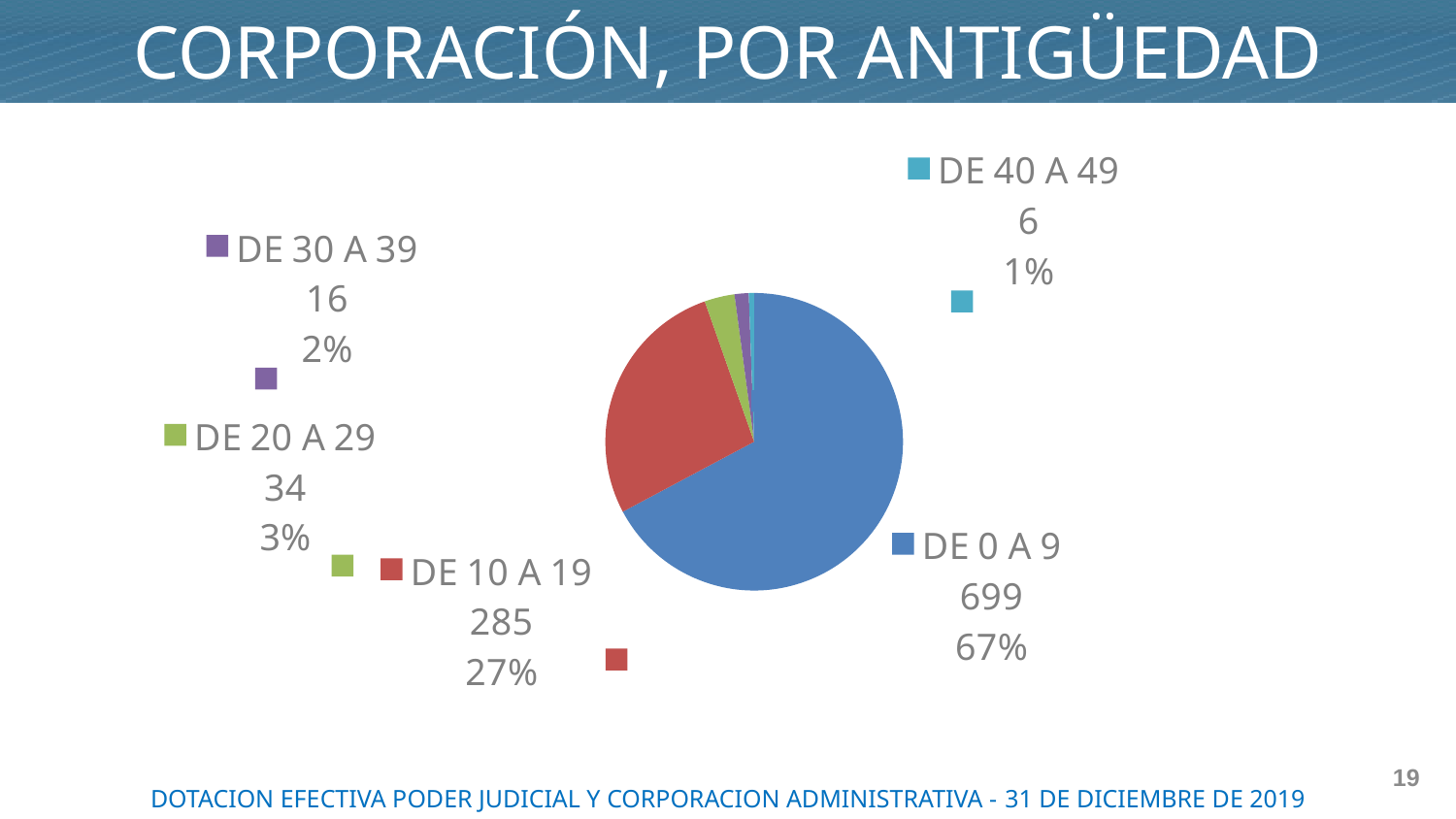
What is the value for DE 20 A 29? 34 What is the difference between the values for DE 0 A 9 and DE 10 A 19? 414 What is the value for DE 0 A 9? 699 What share of the pie does DE 10 A 19 represent? 27% What is the value for DE 40 A 49? 6 Which is larger, the value for DE 20 A 29 or DE 30 A 39? DE 20 A 29 How many categories does the pie chart show? 5 Which category has the smallest share of the pie? DE 40 A 49 What is the value for DE 30 A 39? 16 Which category has the largest share of the pie? DE 0 A 9 What is the value for DE 10 A 19? 285 What kind of chart is shown on the slide? pie chart